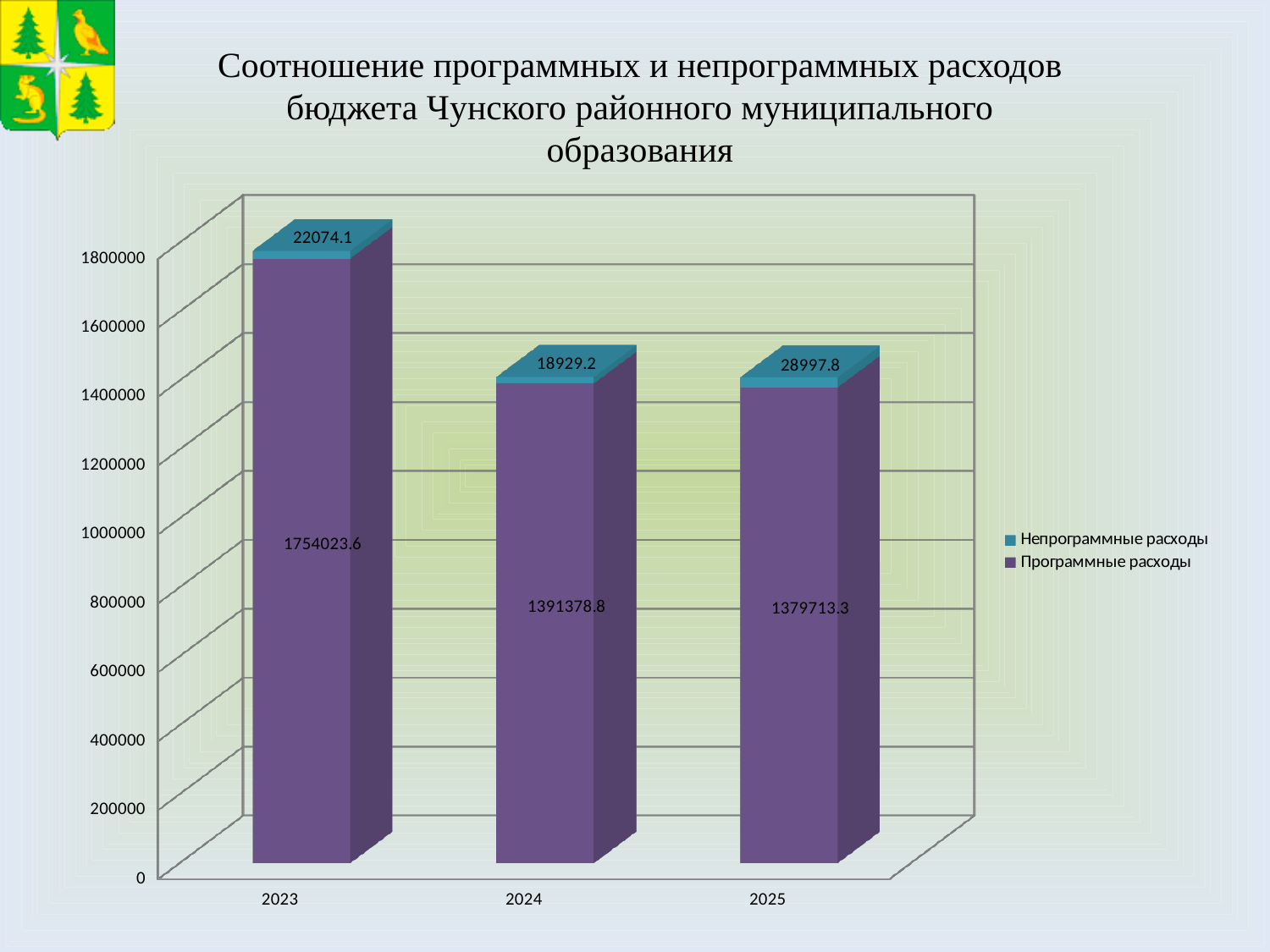
Which year has the lowest value of Программные расходы? 2025 Which year has the highest value of Непрограммные расходы? 2025 Which is larger: Непрограммные расходы in 2023 or in 2024? 2023 What is the value of Программные расходы for 2024? 1391378.8 What is the total of the stacked bar for 2024? 1410308.0 How many years are shown on the x axis? 3 How many series does the legend list? 2 What is the difference between Программные расходы in 2023 and 2024? 362644.8 What kind of chart is shown on the slide? Stacked bar chart What is the value of Программные расходы for 2023? 1754023.6 What is the value of Непрограммные расходы for 2025? 28997.8 Do the values of Программные расходы rise or fall from 2023 to 2025? Fall